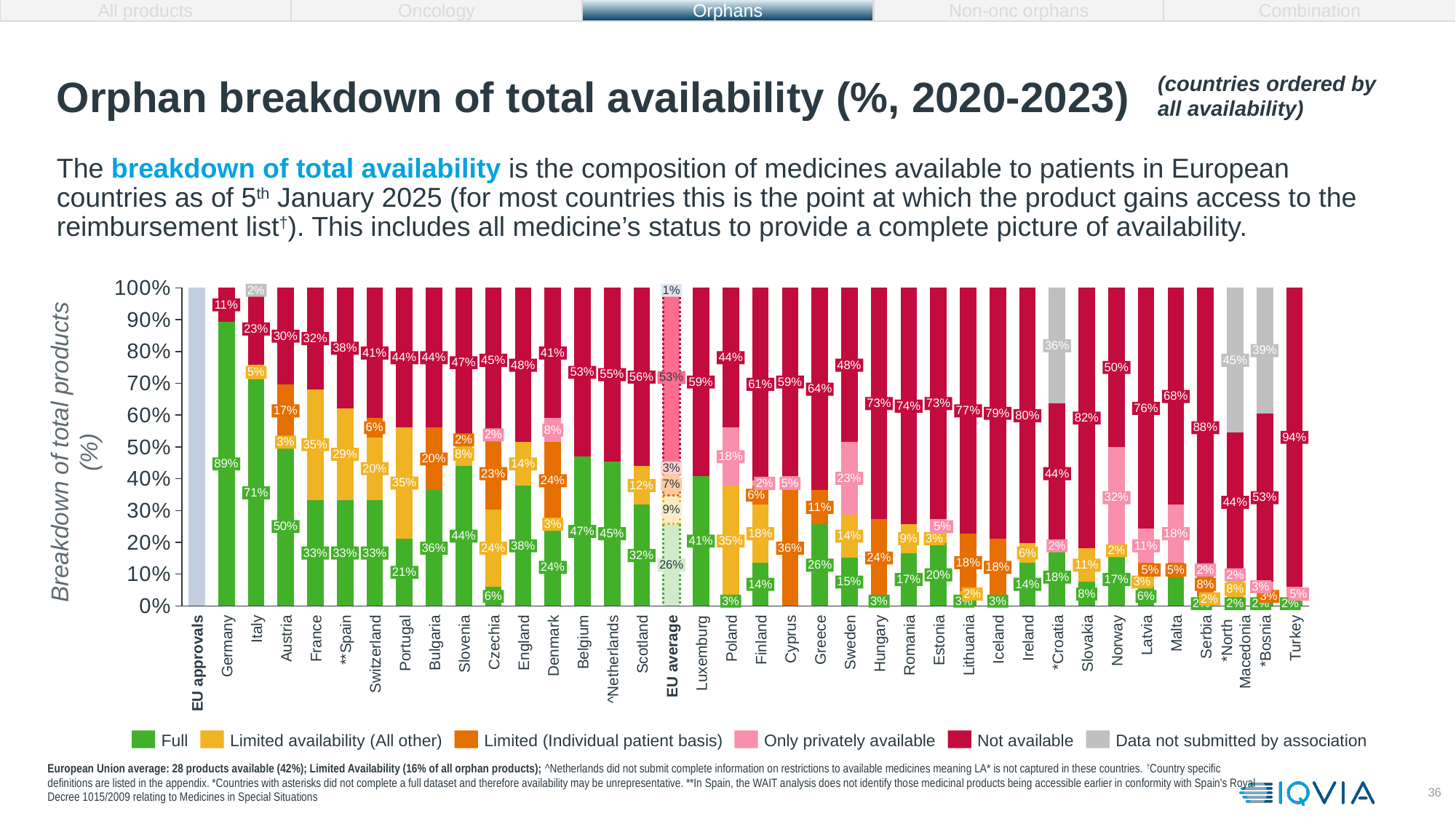
What is the 'Full' availability value for Luxemburg? 41% What is the difference in 'Full' availability between Germany (89%) and Italy (71%)? 18 percentage points What is the 'Not available' value for Turkey? 94% What kind of chart is shown on the slide? Stacked bar chart Which country has the highest 'Full' availability share? Germany How many series does the legend list? 6 Which has a larger 'Full' availability share, Germany or Italy? Germany What is the 'Data not submitted by association' value for *Bosnia? 39% What is the 'Data not submitted by association' value for *Croatia? 36% What is the 'Only privately available' value for Poland? 18% What is the 'Not available' value for Italy? 23% What is the 'Full' availability value for Germany? 89%